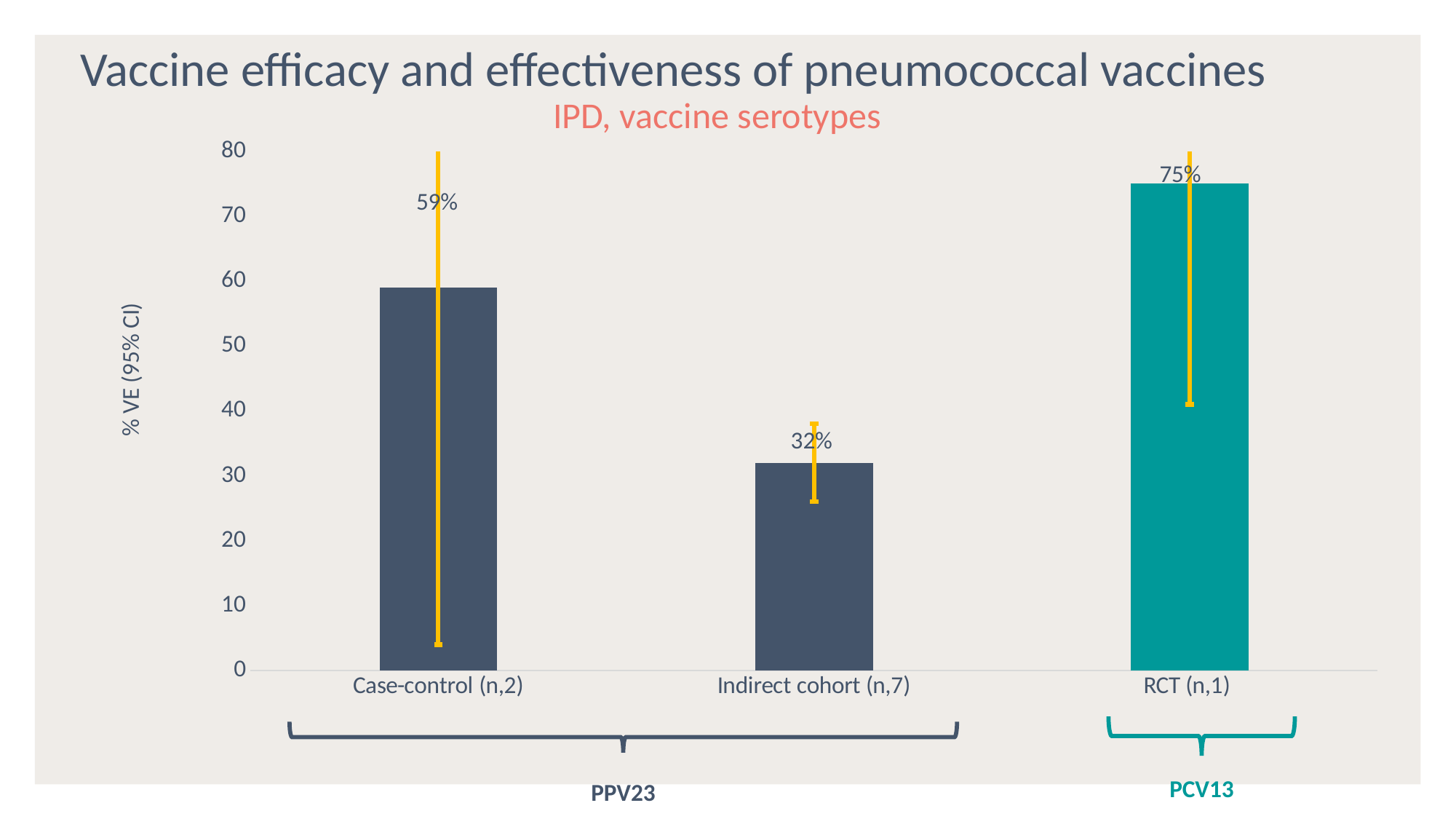
What is the label of the y axis? % VE (95% CI) What kind of chart is shown on the slide? bar chart Is the value for Indirect cohort (n,7) greater or less than 40? less What is the value for RCT (n,1)? 75% What is the difference between the values for Case-control (n,2) and Indirect cohort (n,7)? 27% Which category has the highest value? RCT (n,1) Which category has the lowest value? Indirect cohort (n,7) Which is larger, the value for Case-control (n,2) or the value for Indirect cohort (n,7)? Case-control (n,2) What is the difference between the values for RCT (n,1) and Case-control (n,2)? 16% What is the value for Case-control (n,2)? 59% What is the value for Indirect cohort (n,7)? 32% How many categories are shown on the x axis? 3